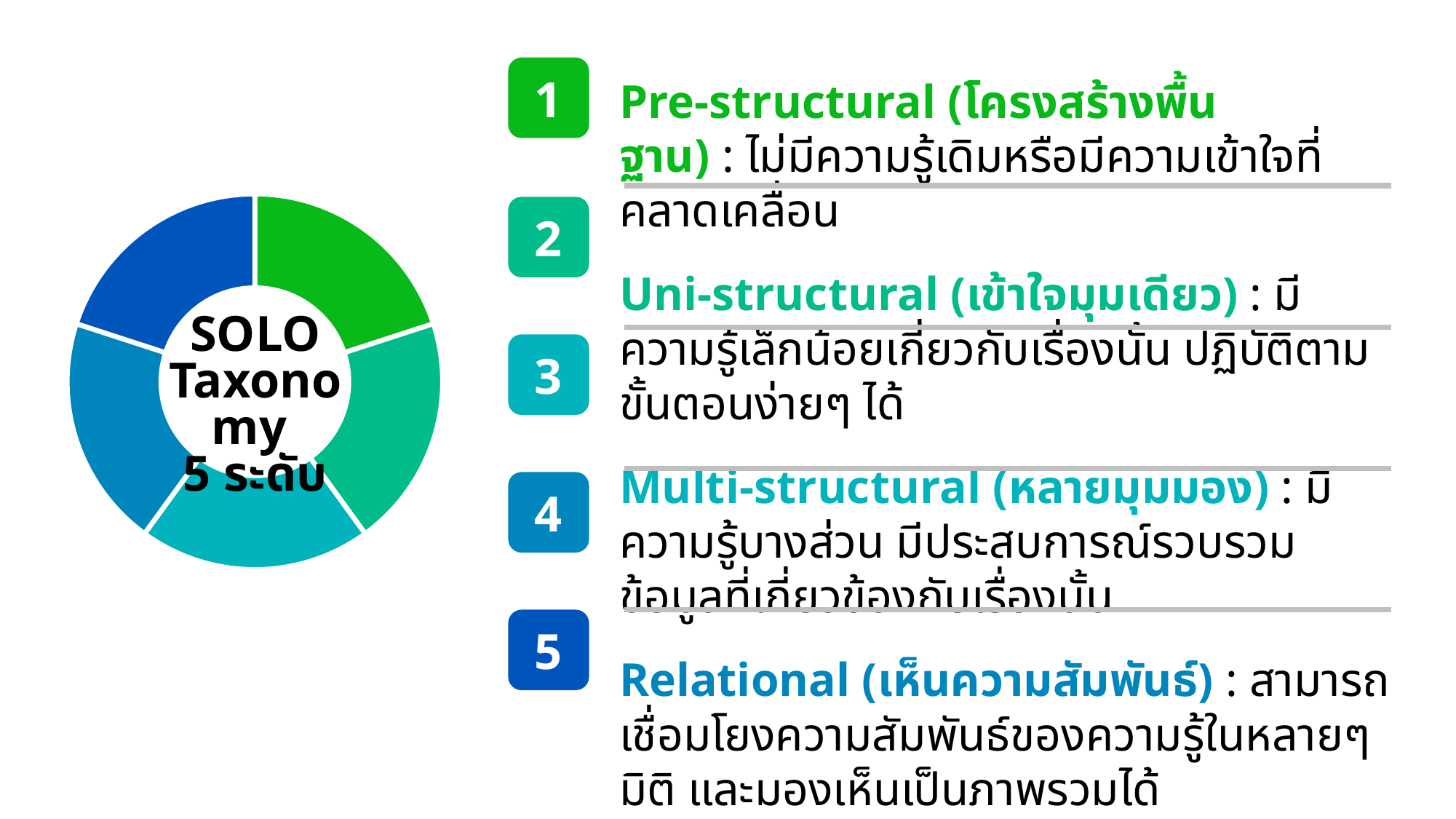
How many segments does the doughnut chart have? 5 Are the five segments of the doughnut chart equal in size? yes What text is written in the centre of the doughnut chart? SOLO Taxonomy 5 ระดับ What kind of chart is shown on the left side of the slide? doughnut chart What colour is the top-right segment of the doughnut chart? green